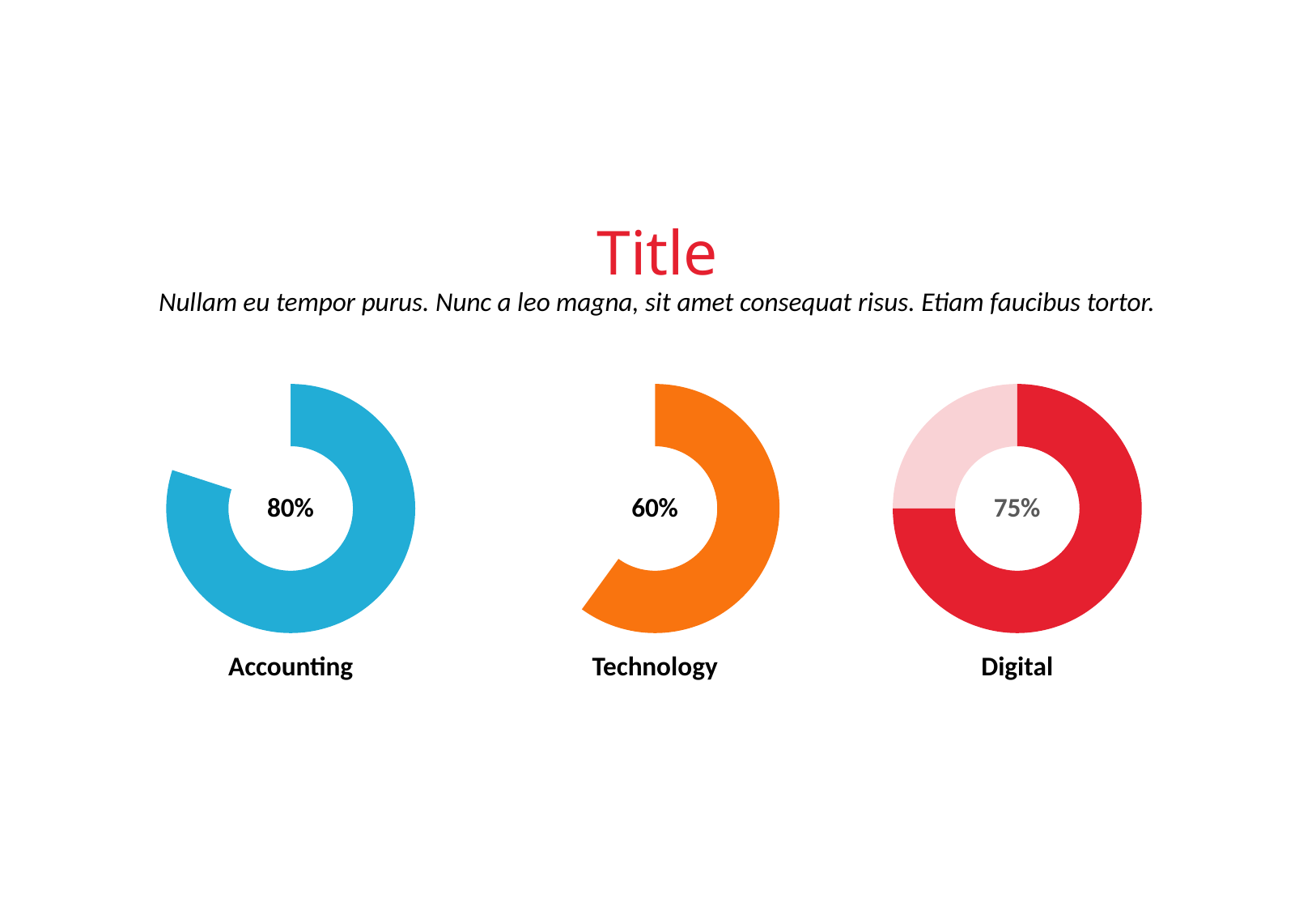
What percentage is shown in the Accounting chart? 80% What is the difference between the Digital percentage and the Technology percentage? 15% Which of the three charts shows the highest percentage? Accounting What kind of chart is used for Accounting, Technology and Digital? Donut chart What percentage is shown in the Technology chart? 60% What is the difference between the Accounting percentage and the Technology percentage? 20% How many donut charts are on the slide? 3 Which of the three charts shows the lowest percentage? Technology What percentage is shown in the Digital chart? 75% Which is larger, the Technology percentage or the Digital percentage? Digital What colour is the Technology chart? Orange Which is larger, the Digital percentage or the Accounting percentage? Accounting